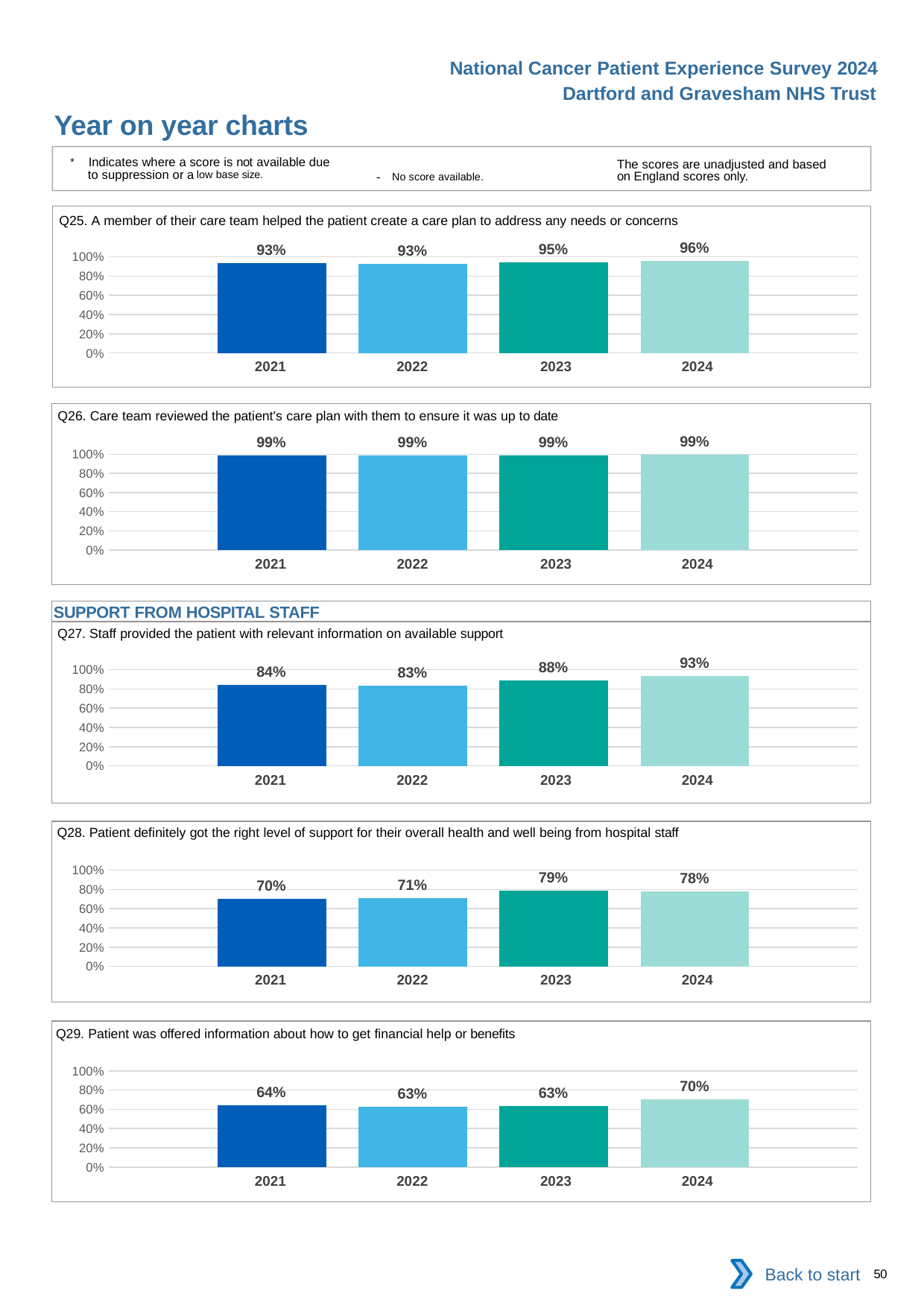
What kind of chart is the Q27 chart? Bar chart In the Q27 chart, what is the difference between the 2024 and 2021 values? 9 percentage points In the Q25 chart, which year has the highest value? 2024 In the Q27 chart, which year has the lowest value? 2022 In the Q27 chart, do the values rise or fall from 2022 to 2024? Rise In the Q28 chart, which is larger, the value for 2021 or the value for 2023? 2023 In the Q29 chart, what is the value for 2024? 70% In the Q29 chart, what is the difference between the 2024 and 2023 values? 7 percentage points How many years are shown on the x axis of the Q28 chart? 4 In the Q26 chart, what is the value for 2021? 99% In the Q25 chart, what is the value for 2024? 96% In the Q28 chart, what is the value for 2023? 79%